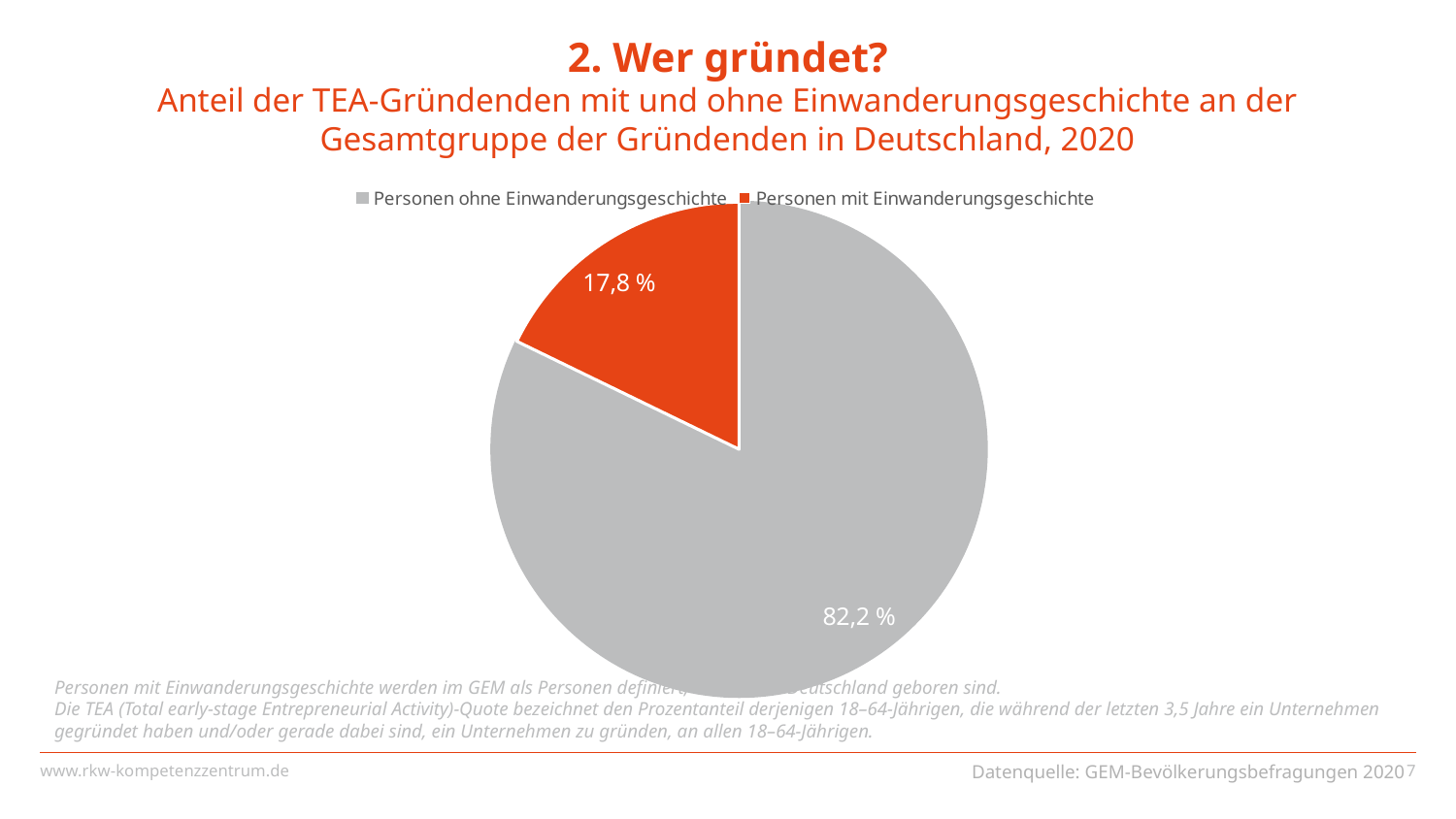
How many entries does the legend list? 2 Is the share for Personen mit Einwanderungsgeschichte greater or less than 20 %? less What year does the chart subtitle refer to? 2020 Which is larger: the share for Personen mit Einwanderungsgeschichte or the share for Personen ohne Einwanderungsgeschichte? Personen ohne Einwanderungsgeschichte What kind of chart is shown on the slide? pie chart What colour is the slice for Personen mit Einwanderungsgeschichte? orange-red Which slice of the pie is the largest? Personen ohne Einwanderungsgeschichte Which slice of the pie is the smallest? Personen mit Einwanderungsgeschichte What share of the pie is labelled for Personen mit Einwanderungsgeschichte? 17,8 % How many slices does the pie chart have? 2 What share of the pie is labelled for Personen ohne Einwanderungsgeschichte? 82,2 % What is the difference in percentage points between the share for Personen ohne Einwanderungsgeschichte and the share for Personen mit Einwanderungsgeschichte? 64,4 %